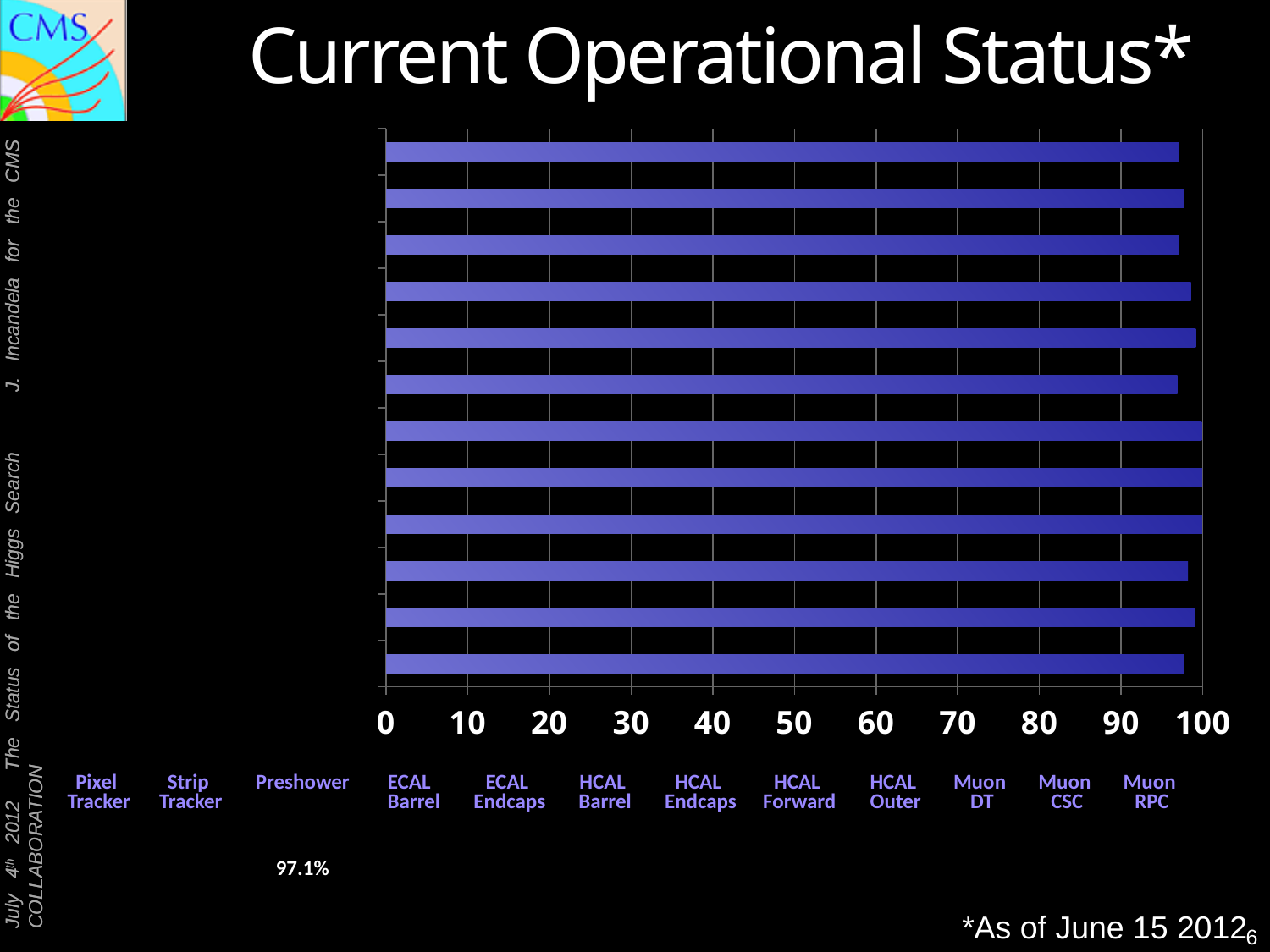
How many bars are plotted in the chart? 12 Is the value for the second bar from the top greater or less than 50? greater What kind of chart is shown on the slide? bar chart Are all of the bars in the chart greater or less than 80? greater Is the value for the seventh bar from the top greater or less than 95? greater What is the title of the slide containing the chart? Current Operational Status* What is the highest value shown on the chart's horizontal axis? 100 How many category labels are listed beneath the chart? 12